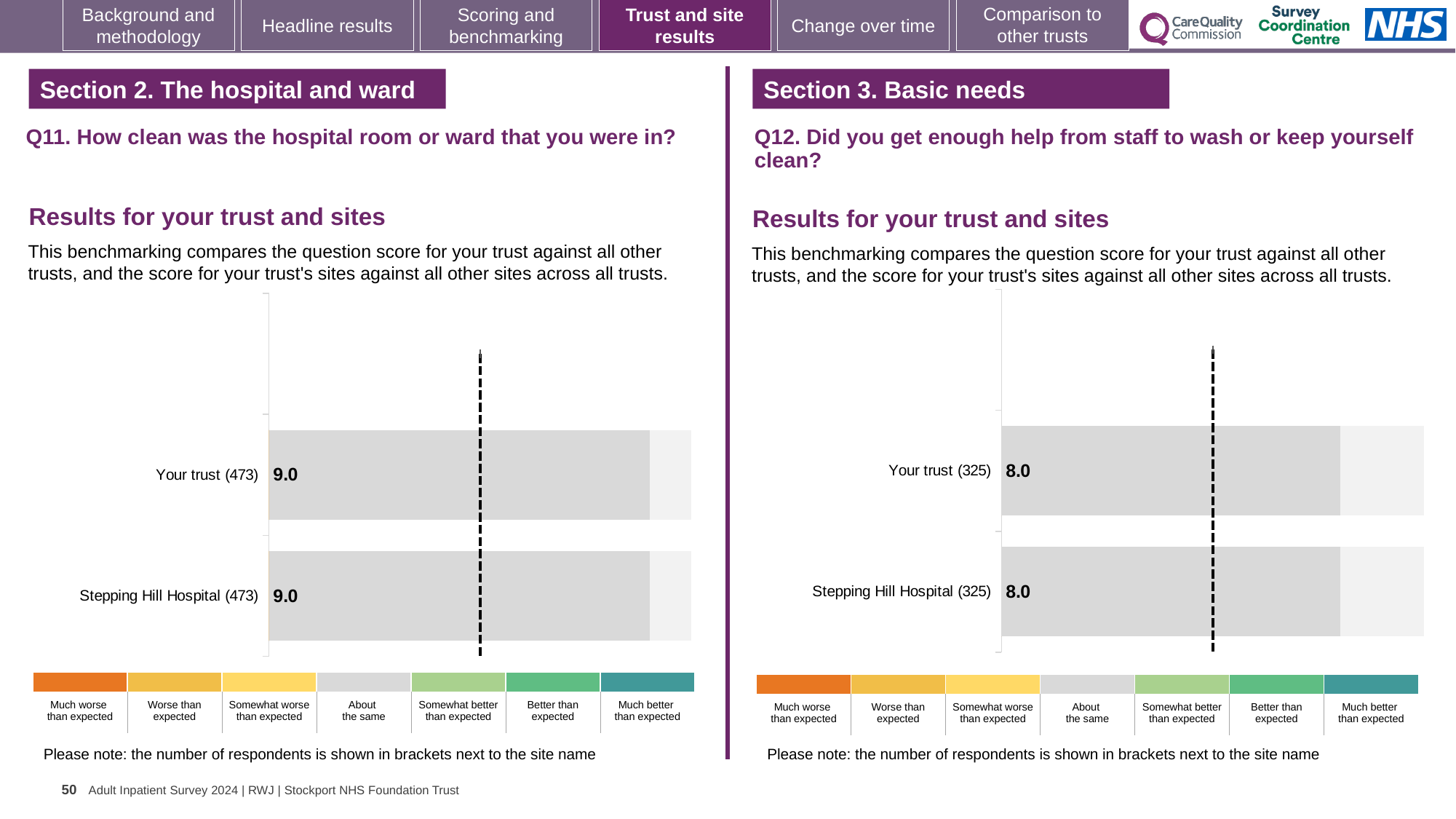
In the Q12 chart on the right, what is the score for Your trust? 8.0 In the Q12 chart on the right, what is the score for Stepping Hill Hospital? 8.0 Is the score for Your trust in the Q11 chart on the left larger or smaller than the score for Your trust in the Q12 chart on the right? Larger In the Q11 chart on the left, what is the score for Stepping Hill Hospital? 9.0 In the Q11 chart on the left, how many bars are plotted? 2 What kind of chart is the Q11 chart on the left? Bar chart In the Q12 chart on the right, what is the difference between the score for Your trust and the score for Stepping Hill Hospital? 0.0 In the Q11 chart on the left, how many respondents are shown in brackets next to Your trust? 473 In the Q12 chart on the right, how many respondents are shown in brackets next to Stepping Hill Hospital? 325 In the Q12 chart on the right, how many bars are plotted? 2 In the Q11 chart on the left, what is the difference between the score for Your trust and the score for Stepping Hill Hospital? 0.0 In the Q11 chart on the left, what is the score for Your trust? 9.0